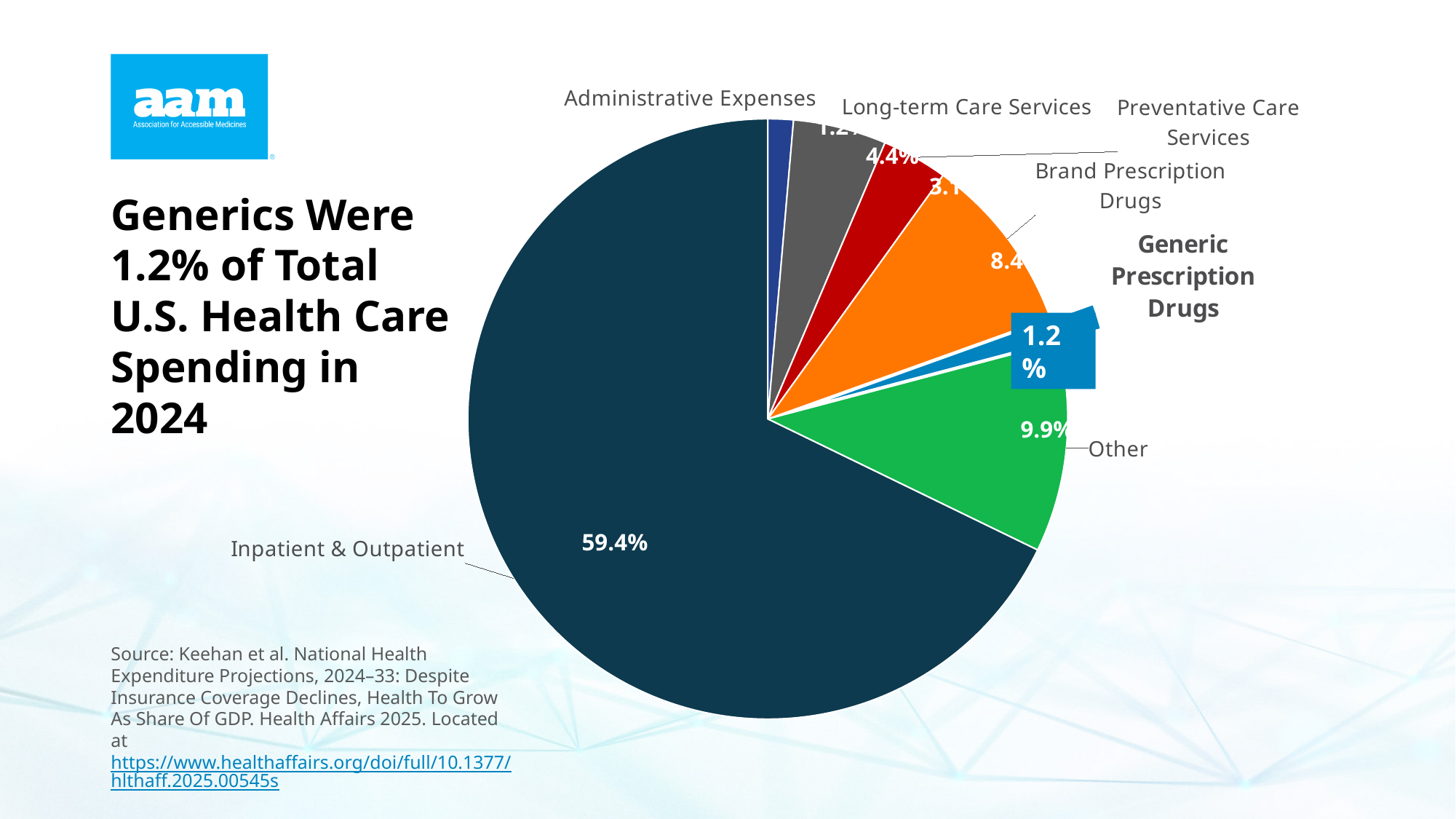
What colour is the Inpatient & Outpatient slice? Dark navy blue Which is larger, the Brand Prescription Drugs slice or the Generic Prescription Drugs slice? Brand Prescription Drugs What type of chart is shown on the slide? Pie chart What is the value shown for the Other slice? 9.9% Which category has the largest slice of the pie? Inpatient & Outpatient How many categories are shown in the pie chart? 7 Which is larger, the Other slice or the Generic Prescription Drugs slice? Other What share of total U.S. health care spending in 2024 was Generic Prescription Drugs? 1.2% What is the difference in percentage points between Other and Generic Prescription Drugs? 8.7 What is the difference in percentage points between Inpatient & Outpatient and Other? 49.5 What is the title of the slide? Generics Were 1.2% of Total U.S. Health Care Spending in 2024 What is the value shown for Inpatient & Outpatient? 59.4%